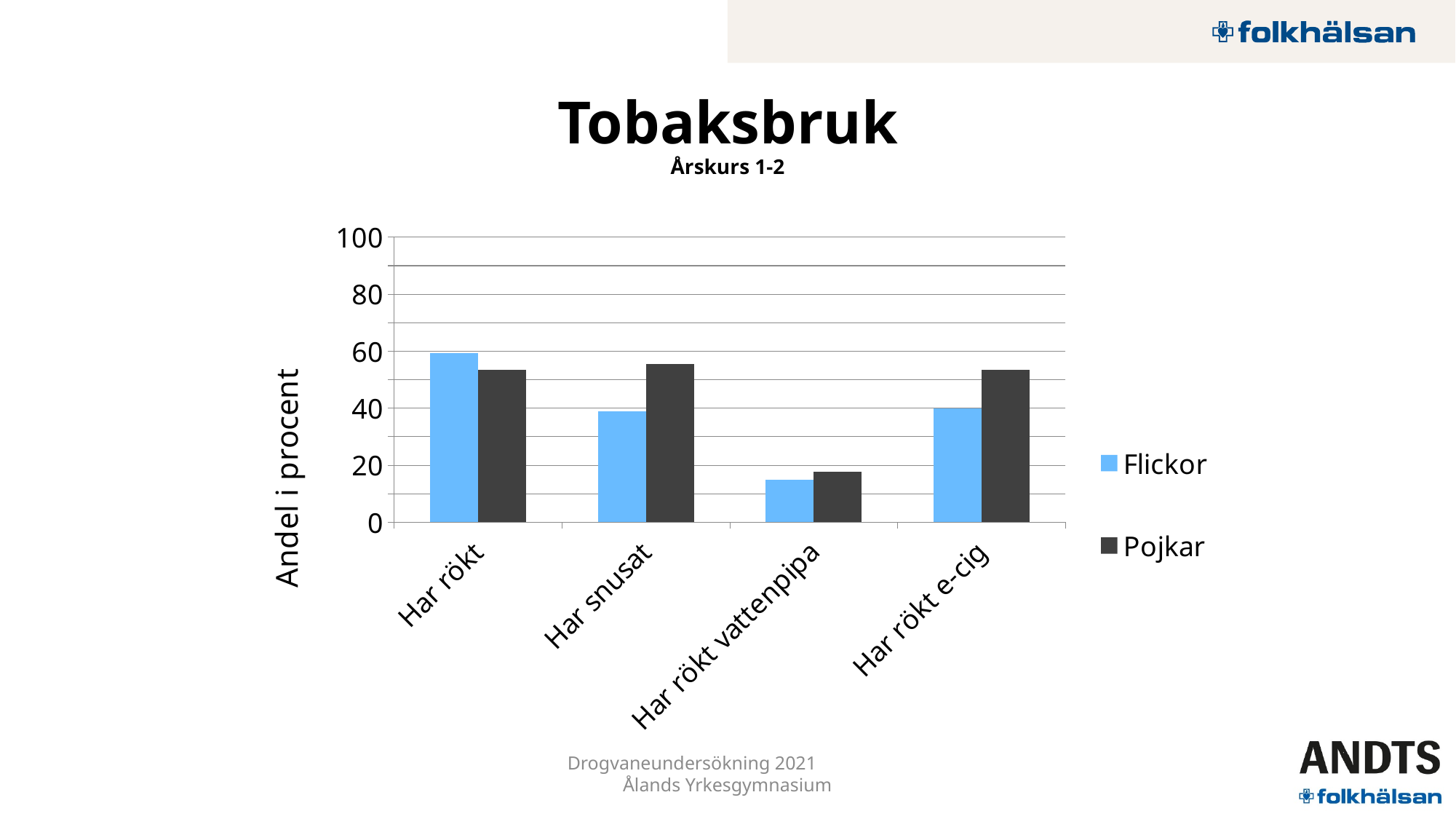
For Har rökt, which series has the larger value, Flickor or Pojkar? Flickor What is the label on the vertical axis of the chart? Andel i procent Which series is shown in light blue in the legend? Flickor What kind of chart is shown on the slide? bar chart For Har snusat, which series has the larger value, Flickor or Pojkar? Pojkar Which category has the lowest value for Pojkar? Har rökt vattenpipa Which category has the highest value for Flickor? Har rökt How many series does the legend list? 2 Which category has the lowest value for Flickor? Har rökt vattenpipa How many categories are shown on the x axis of the chart? 4 Is the value for Flickor in Har rökt vattenpipa greater or less than 20? less Is the value for Pojkar in Har rökt e-cig greater or less than 40? greater